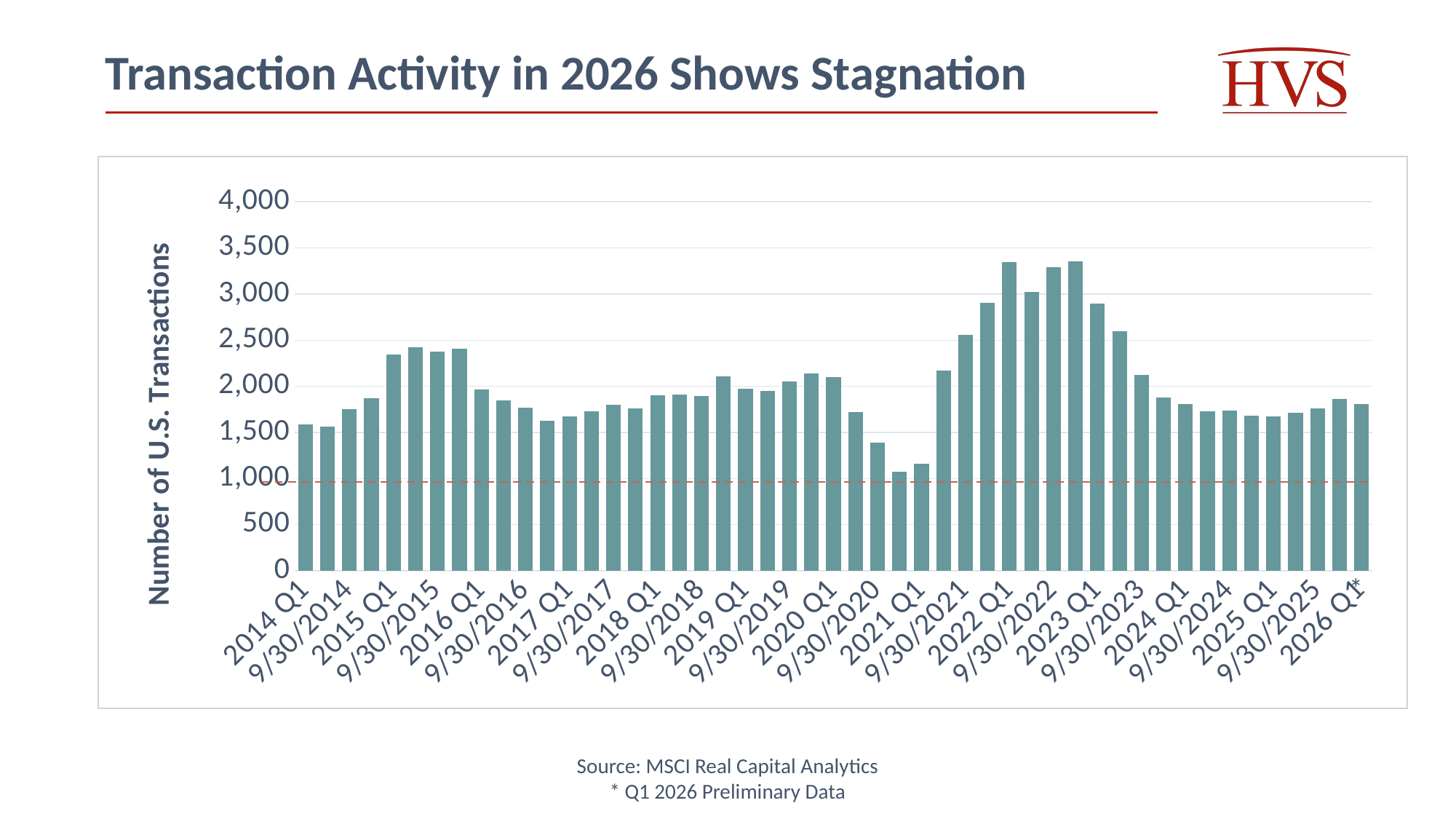
Is the value for 2021 Q1 greater or less than 1,500? less Is the value for 9/30/2020 greater or less than 2,000? less Is the value for 2026 Q1 greater or less than 2,000? less What kind of chart is shown on the slide? bar chart Which is larger, the value for 2021 Q1 or the value for 2026 Q1? 2026 Q1 Do the values rise or fall from 2023 Q1 to 2024 Q1? fall What is the title of the vertical axis? Number of U.S. Transactions Do the values rise or fall from 2021 Q1 to 2022 Q1? rise Which is larger, the value for 2022 Q1 or the value for 2014 Q1? 2022 Q1